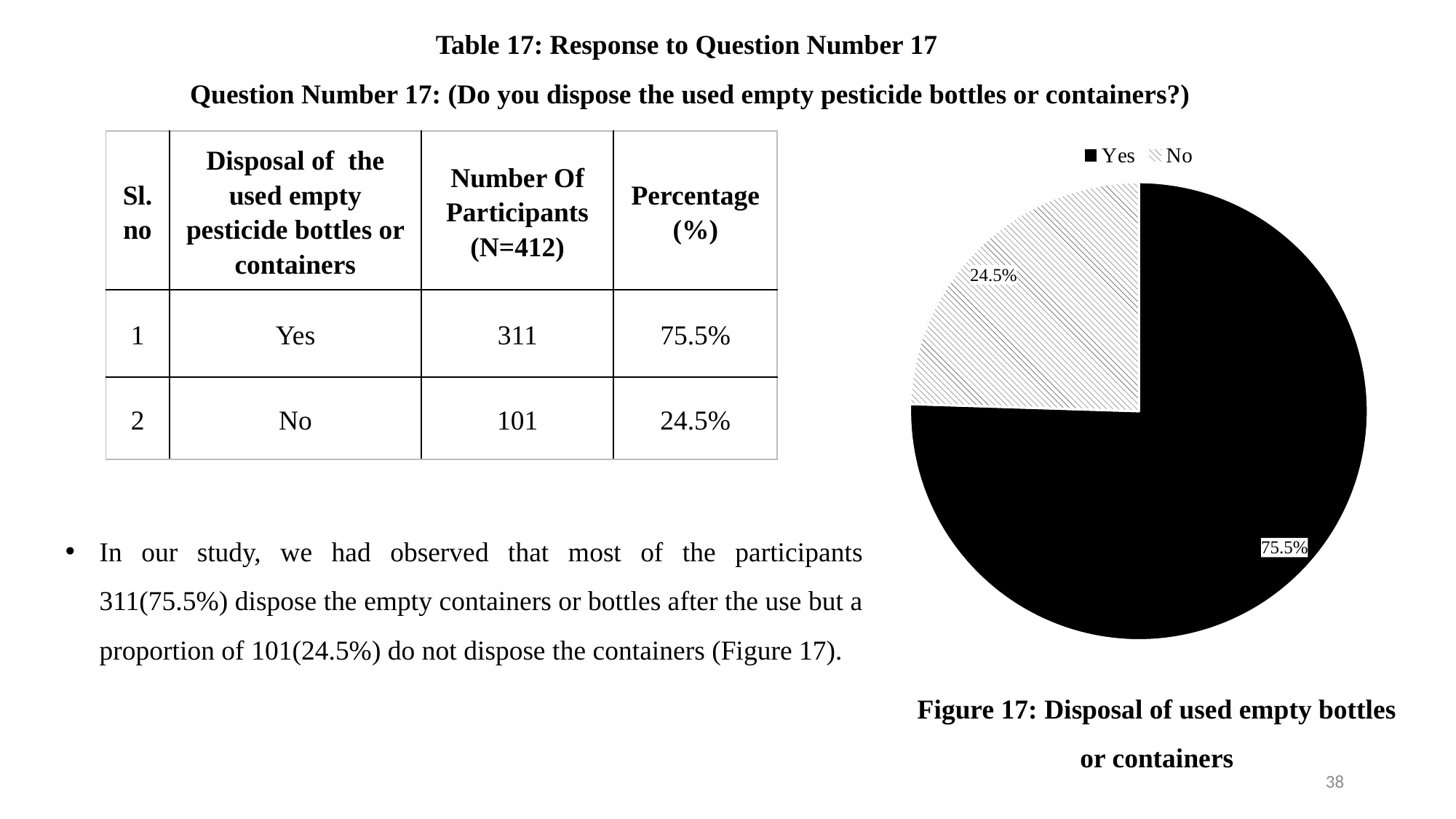
Which category has the largest slice in the pie chart? Yes What percentage does the Yes slice show in the pie chart? 75.5% What percentage does the No slice show in the pie chart? 24.5% Which slice is larger in the pie chart, Yes or No? Yes How many slices does the pie chart have? 2 Which category has the smallest slice in the pie chart? No What is the caption of the pie chart? Figure 17: Disposal of used empty bottles or containers What kind of chart is shown in Figure 17? pie chart Is the Yes slice of the pie chart greater or less than 50%? greater Which slice of the pie chart is drawn with a hatched pattern? No How many entries does the legend of the pie chart list? 2 What is the difference in percentage points between the Yes and No slices in the pie chart? 51 percentage points